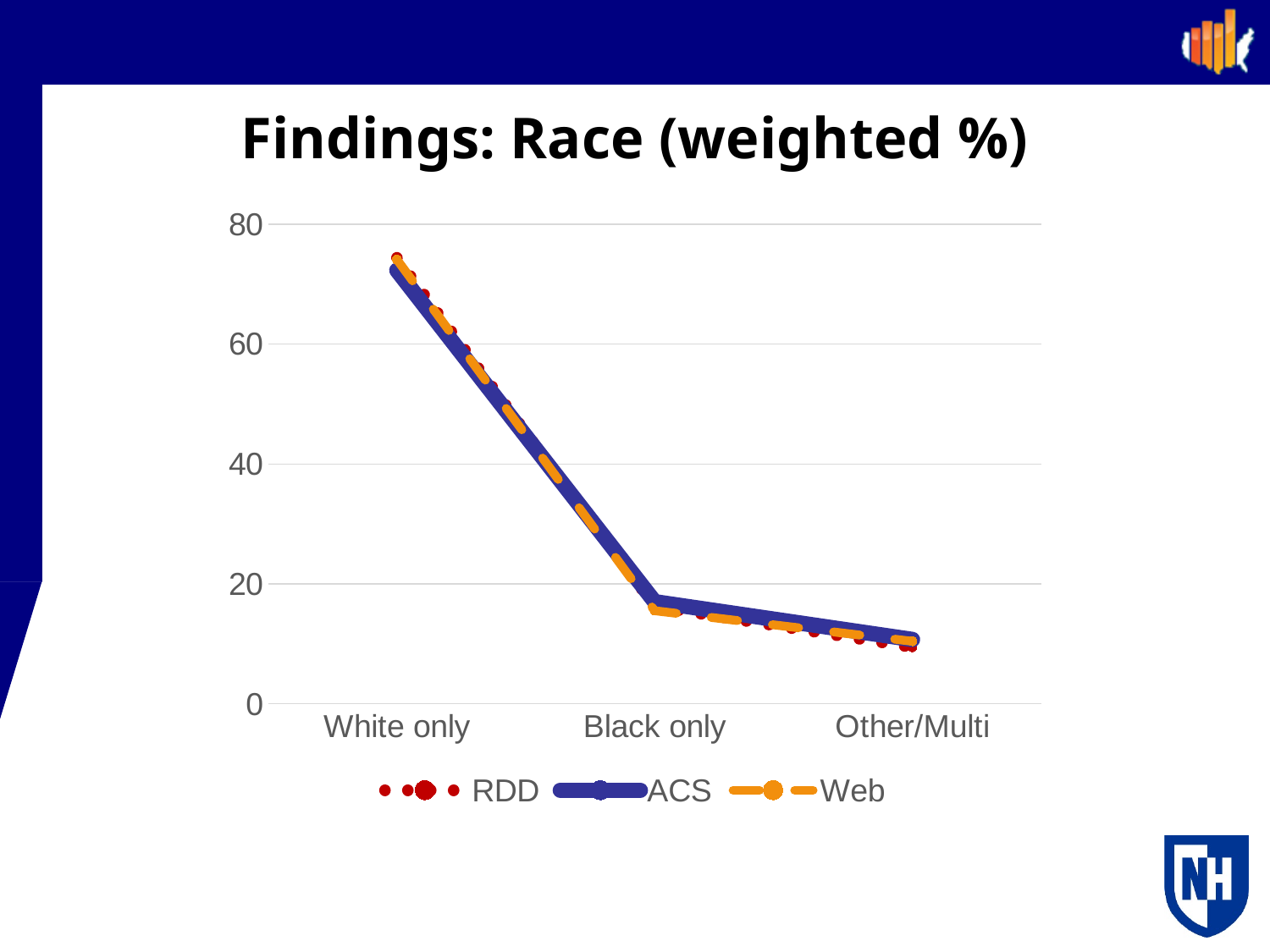
How many categories are shown on the x axis? 3 Is the value for Other/Multi in the RDD series greater or less than 20? less Which category has the lowest value for the RDD series? Other/Multi Which category has the highest value for the ACS series? White only What is the title of the chart? Findings: Race (weighted %) Is the value for White only in the ACS series greater or less than 60? greater Do the values rise or fall moving from White only to Other/Multi along the x axis? fall Which series are listed in the legend? RDD, ACS, Web For the Web series, which is larger: the value for White only or the value for Black only? White only How many series does the legend list? 3 Is the value for Black only in the Web series greater or less than 20? less What kind of chart is shown on the slide? line chart